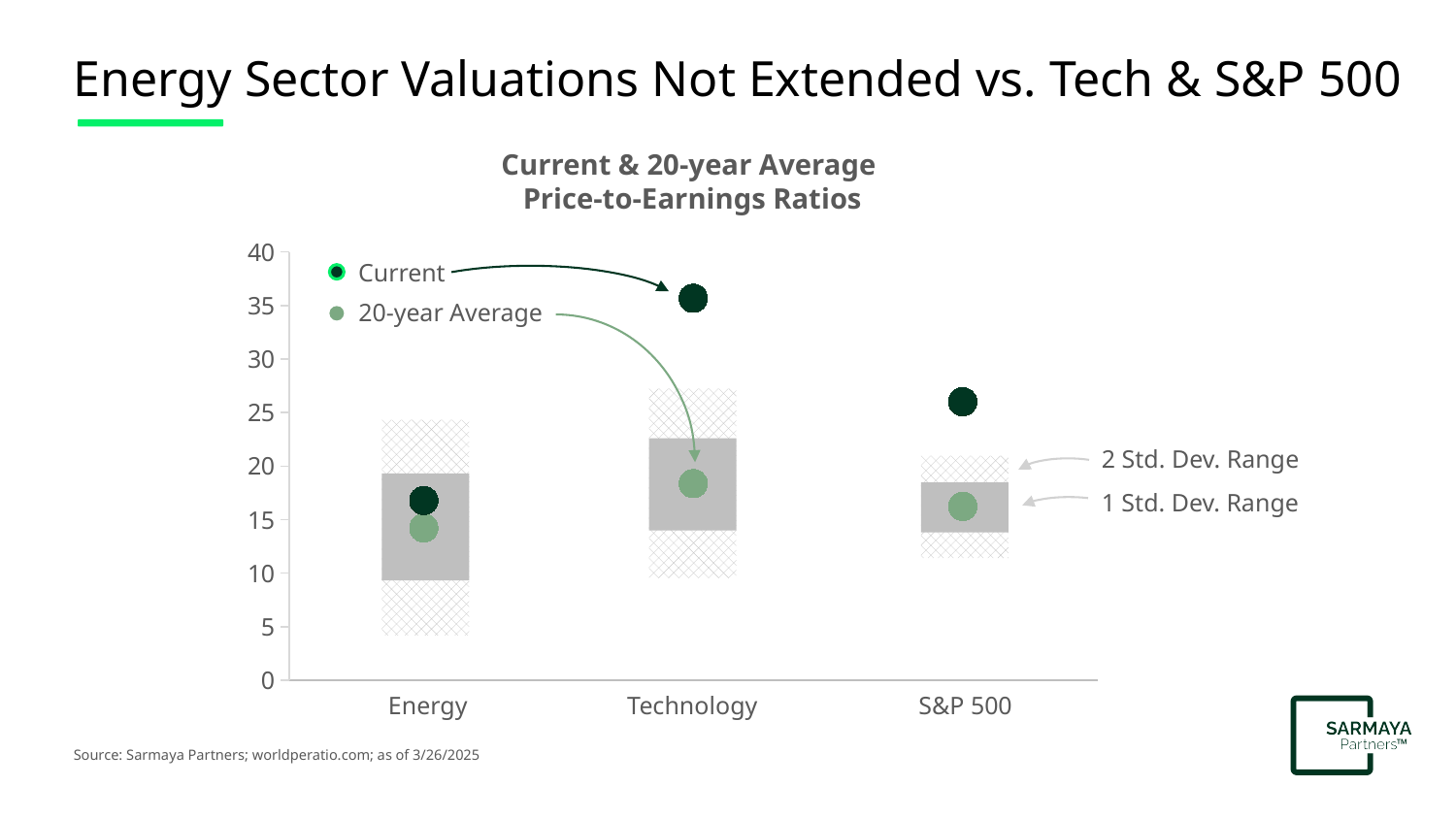
What is the title of the chart? Current & 20-year Average Price-to-Earnings Ratios Which category has the highest Current price-to-earnings ratio? Technology Is the Current value for Energy greater or less than 20? less What do the two shaded bands around each 20-year Average point represent, according to the chart annotations? 2 Std. Dev. Range and 1 Std. Dev. Range Is the 20-year Average value for Technology greater or less than 20? less How many series does the chart's legend list? 2 Is the Current value for S&P 500 greater or less than 25? greater Which category has the lowest Current price-to-earnings ratio? Energy How many categories are shown on the x axis of the chart? 3 Which category has the highest 20-year Average price-to-earnings ratio? Technology Which is larger, the Current value for S&P 500 or the Current value for Energy? S&P 500